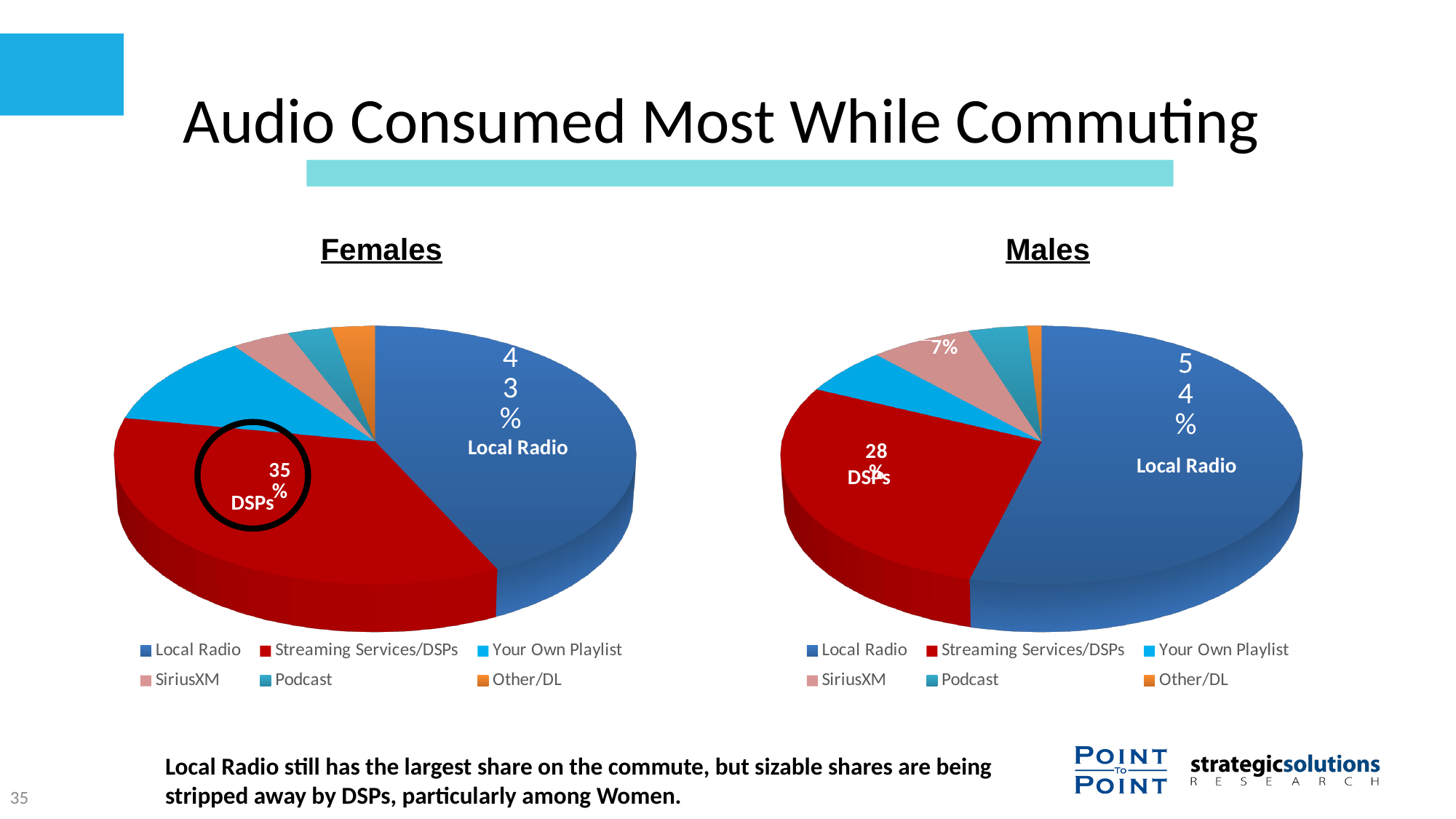
In the Males chart, what share does Local Radio have? 54% In the Males chart, what is the difference between the Local Radio share and the DSPs share? 26% In the Males chart, what share does SiriusXM have? 7% Which chart shows a larger share for Local Radio, Females or Males? Males In the Males chart, which category has the largest slice? Local Radio In the Females chart, what is the difference between the Local Radio share and the DSPs share? 8% In the Females chart, which category has the largest slice? Local Radio How many categories does the legend of the Females chart list? 6 What type of chart is used for the Males data? Pie chart In the Females chart, what share does Local Radio have? 43% In the Females chart, what share do DSPs have? 35% In the Males chart, what share do DSPs have? 28%